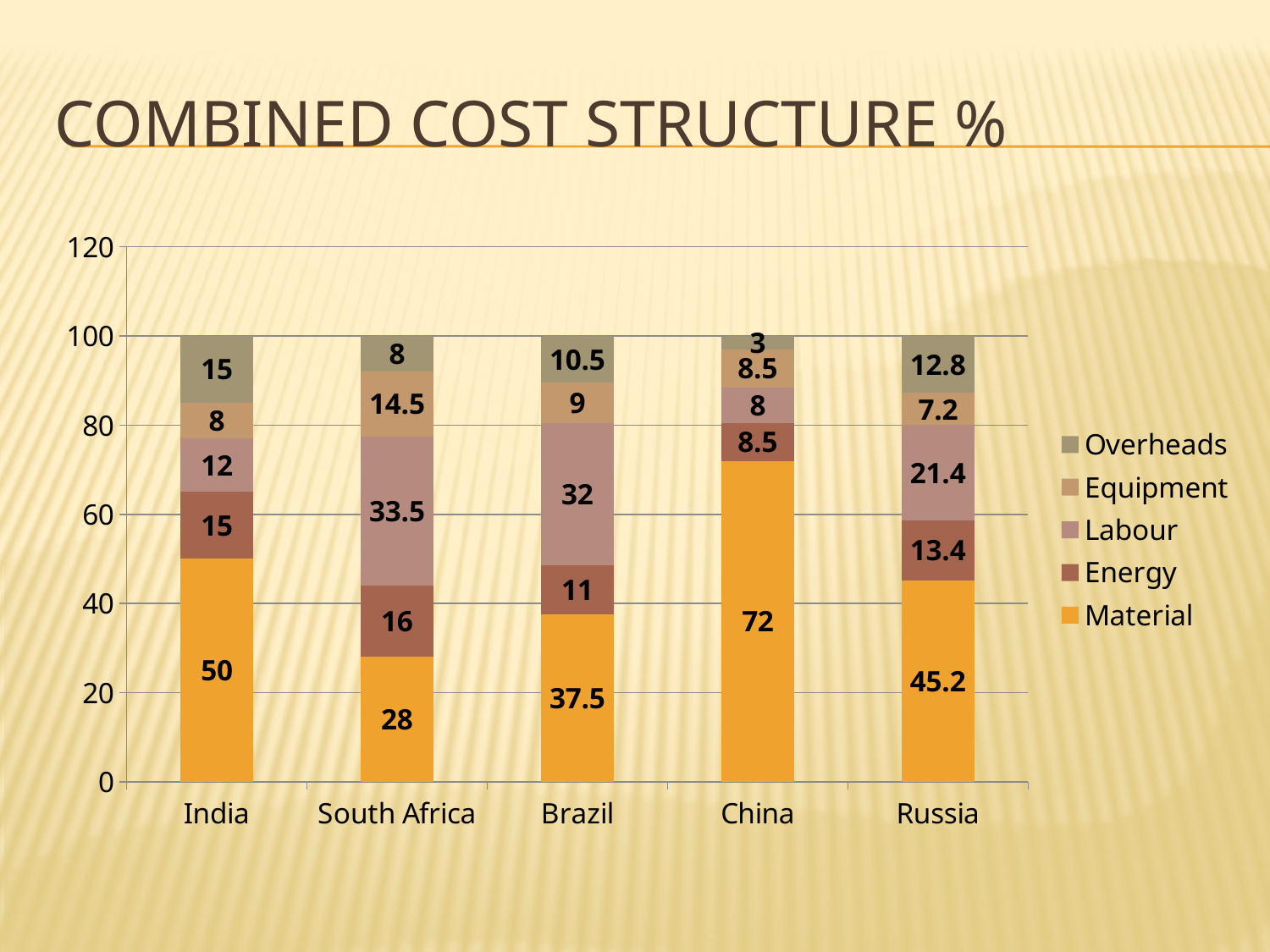
Which country has the lowest Overheads value? China What is the difference between the Material values for China and India? 22 Which country has the highest Material value? China What is the Material value for China? 72 What is the total of the stacked bar for Brazil? 100 Which is larger, the Labour value for Brazil or the Labour value for Russia? Brazil How many countries are shown on the x axis? 5 What kind of chart is shown on the slide? Stacked bar chart How many series does the legend list? 5 What is the title of the chart? COMBINED COST STRUCTURE % What is the Labour value for South Africa? 33.5 What is the Overheads value for Russia? 12.8